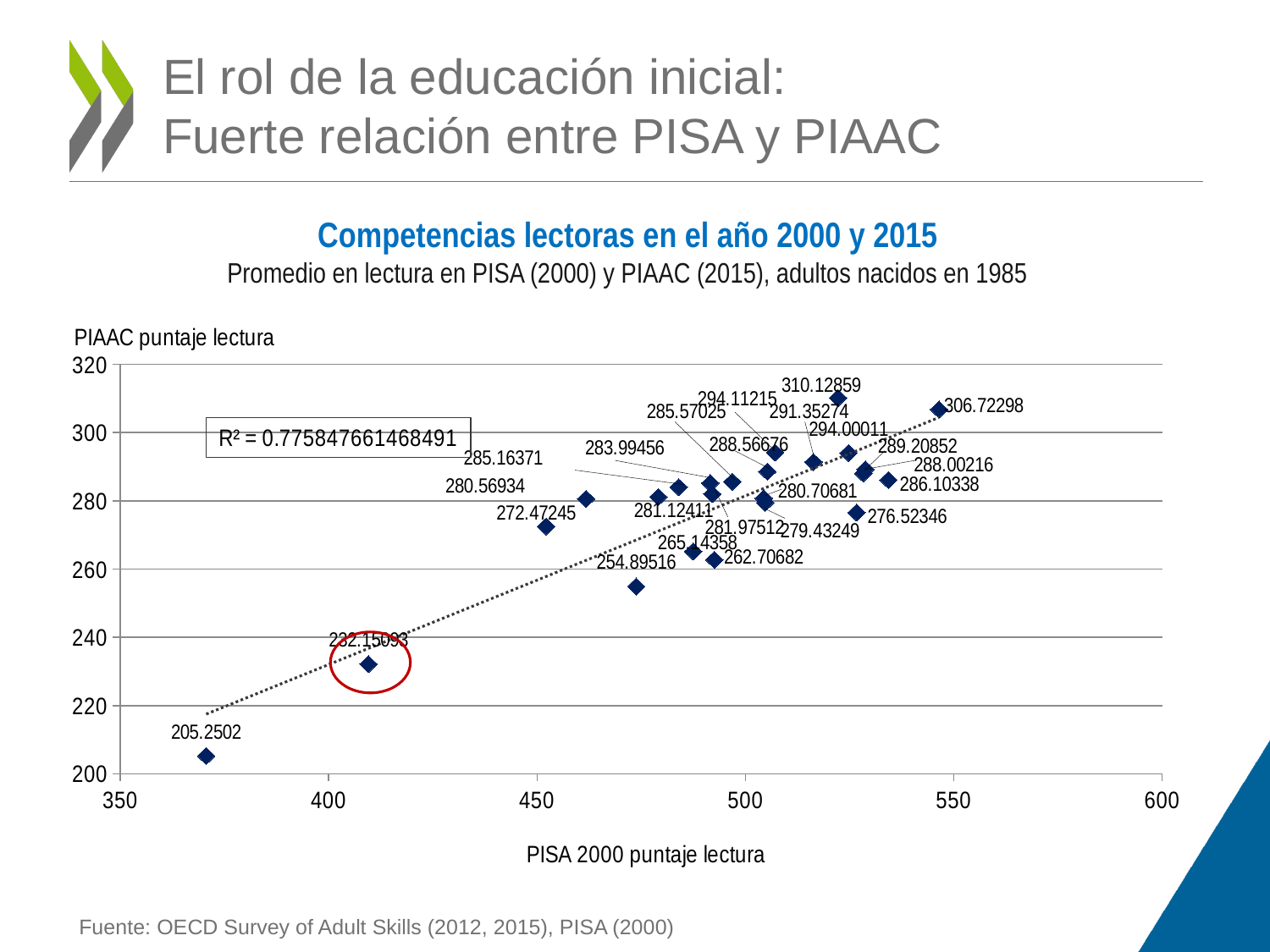
Is the PIAAC reading score of the point circled in red greater or less than 240? less What is the highest PIAAC reading score labelled on the chart? 310.12859 What is the difference between the highest labelled PIAAC score (310.12859) and the lowest (205.2502)? 104.87839 What R² value is shown on the chart? 0.775847661468491 Is the PISA 2000 reading score of the point labelled 306.72298 greater or less than 500? greater Do PIAAC reading scores generally rise or fall as PISA 2000 reading scores increase along the x axis? rise Which is larger, the point labelled 254.89516 or the point labelled 262.70682? 262.70682 What is the lowest PIAAC reading score labelled on the chart? 205.2502 Is the PISA 2000 reading score of the point labelled 205.2502 greater or less than 400? less How many data points are plotted on the chart? 24 What kind of chart is shown on the slide? scatter chart What is the title of the horizontal axis? PISA 2000 puntaje lectura